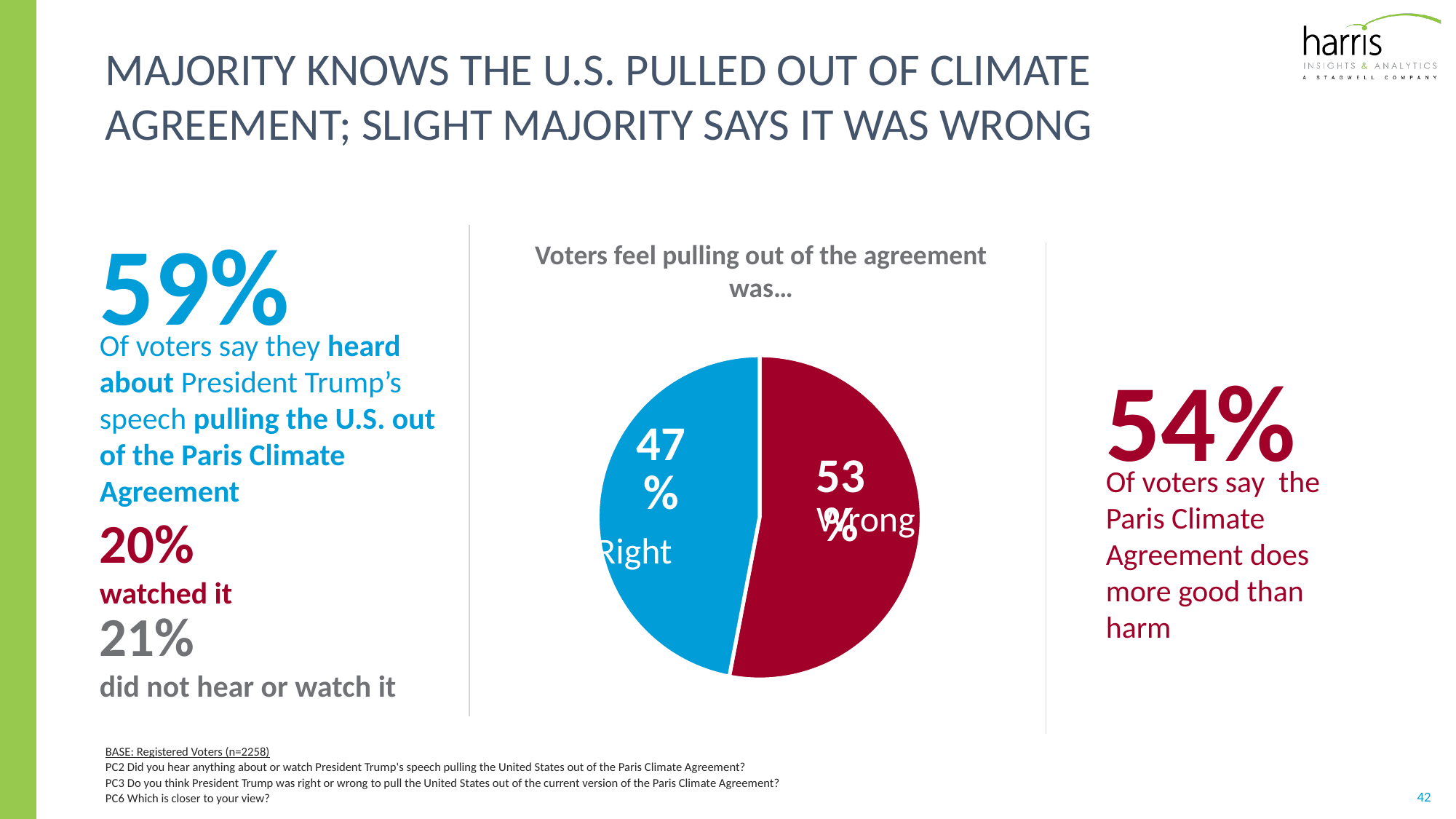
What share of voters say pulling out of the agreement was Right? 47% Which slice of the pie is the smallest? Right What is the title of the chart? Voters feel pulling out of the agreement was… What is the combined share of the Right and Wrong slices? 100% What share of voters say pulling out of the agreement was Wrong? 53% What colour is the Right slice of the pie? blue How many slices does the pie chart have? 2 What kind of chart is shown on the slide? pie chart Which is larger, the Right slice or the Wrong slice? Wrong Which slice of the pie is the largest? Wrong What is the difference in percentage points between the Wrong and Right slices? 6